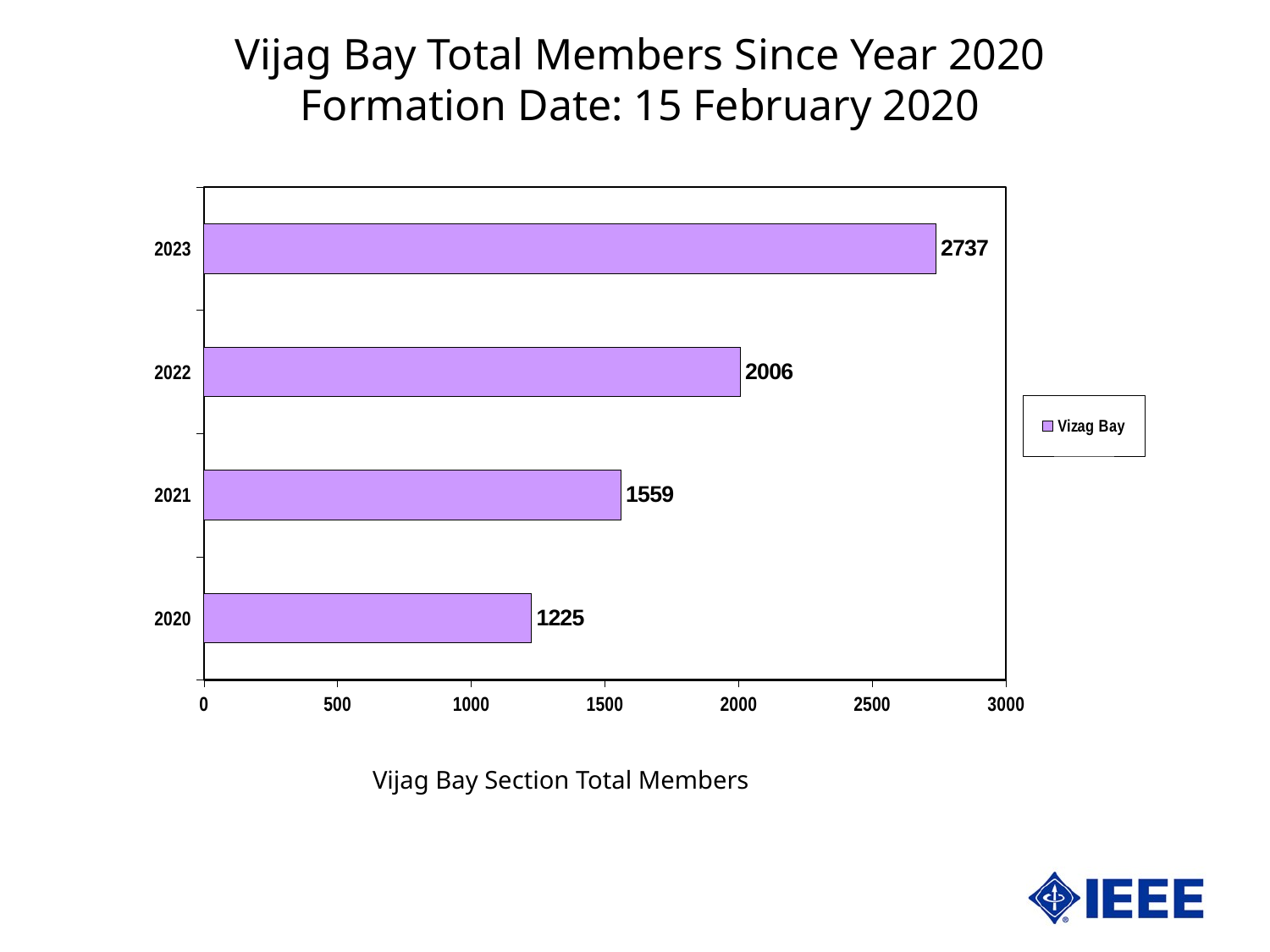
What series name is listed in the legend? Vizag Bay Which year has the lowest number of members? 2020 What is the total number of members for 2021? 1559 What is the total number of members for 2020? 1225 What is the total number of members for 2022? 2006 What is the total number of members for 2023? 2737 Which year has more members, 2021 or 2022? 2022 What is the difference in members between 2021 and 2020? 334 What kind of chart is shown on the slide? Bar chart How many years are shown in the chart? 4 Which year has the highest number of members? 2023 What is the difference in members between 2023 and 2022? 731